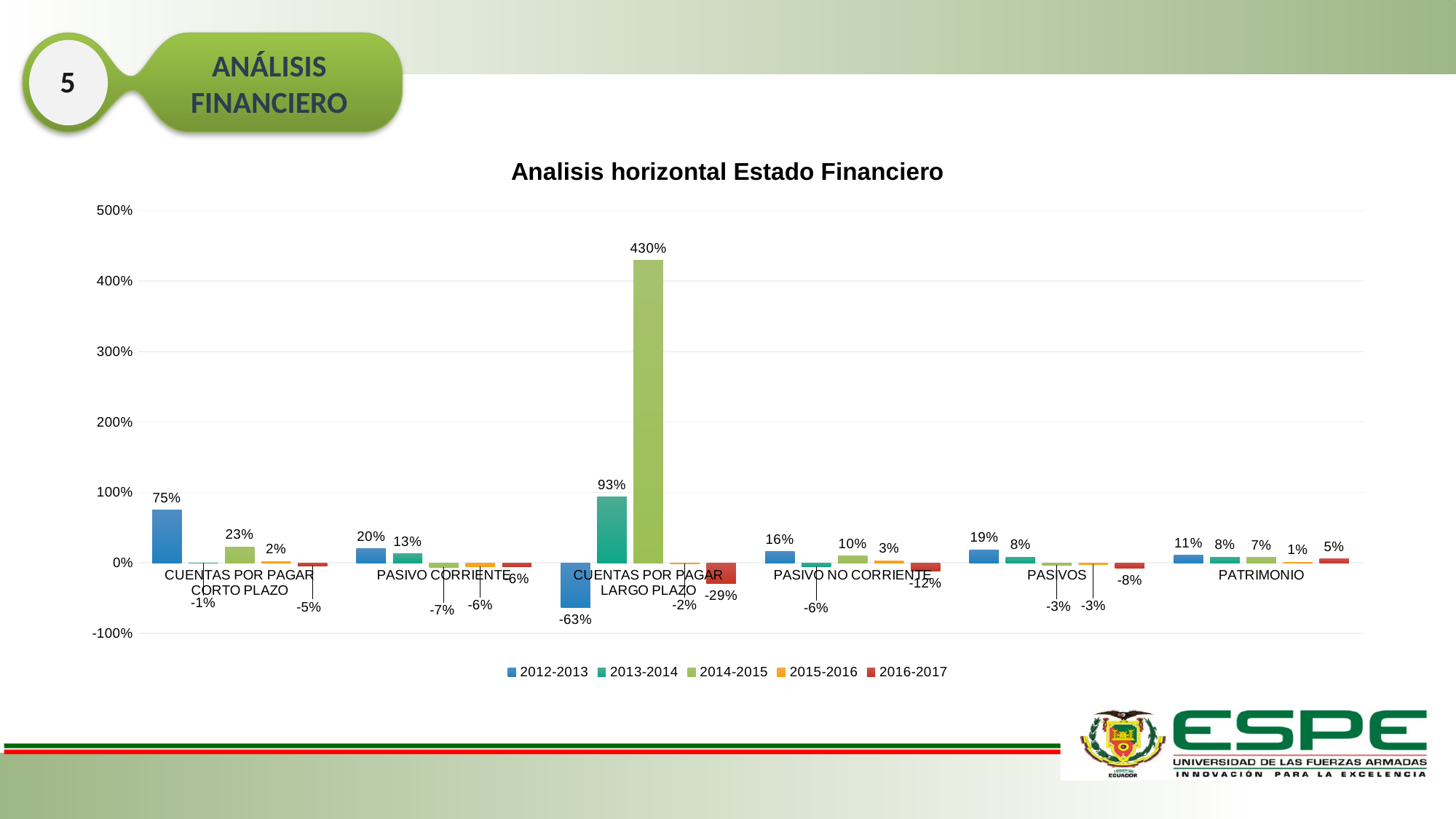
Which category has the highest value for the 2014-2015 series? CUENTAS POR PAGAR LARGO PLAZO What is the value for 2012-2013 in the CUENTAS POR PAGAR CORTO PLAZO category? 75% How many series does the legend list? 5 Is the 2014-2015 value for CUENTAS POR PAGAR LARGO PLAZO greater or less than 400%? greater Which category has the lowest value for the 2012-2013 series? CUENTAS POR PAGAR LARGO PLAZO How many categories are shown on the x axis? 6 What type of chart is shown on the slide? Bar chart What is the value for 2016-2017 in the PASIVO NO CORRIENTE category? -12% What is the difference between the 2014-2015 and 2013-2014 values in the CUENTAS POR PAGAR LARGO PLAZO category? 337% What is the value for 2013-2014 in the PATRIMONIO category? 8% What is the value for 2014-2015 in the CUENTAS POR PAGAR LARGO PLAZO category? 430% Which is larger in the PASIVOS category: the 2012-2013 value or the 2013-2014 value? 2012-2013